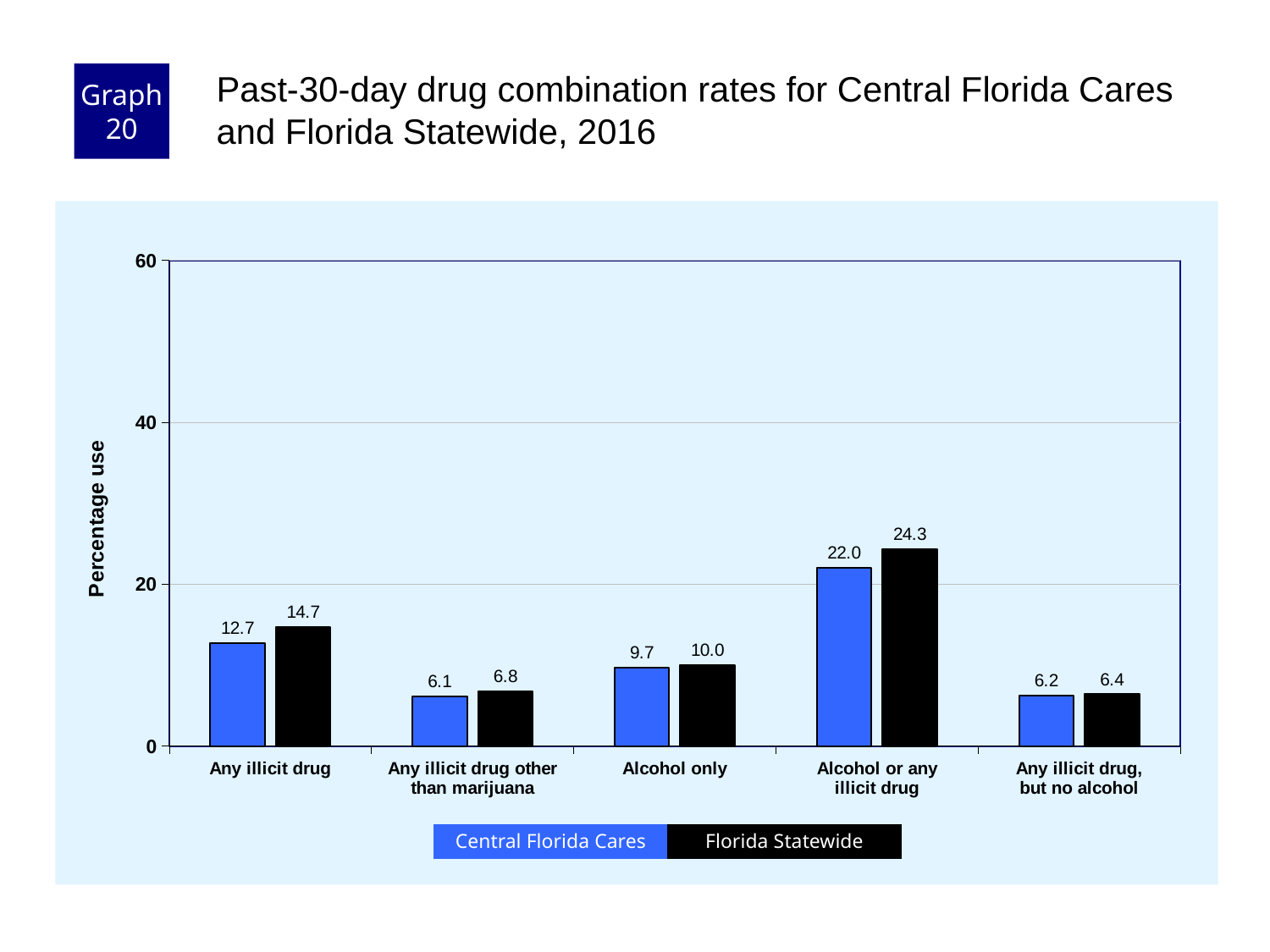
What is the difference between the Florida Statewide and Central Florida Cares values for Alcohol or any illicit drug? 2.3 Is the Florida Statewide value for Alcohol or any illicit drug greater or less than 20? greater What kind of chart is shown on the slide? Bar chart Which category has the lowest Florida Statewide value? Any illicit drug, but no alcohol What is the Florida Statewide value for Alcohol or any illicit drug? 24.3 How many series does the legend list? 2 What is the Florida Statewide value for Alcohol only? 10.0 What is the difference between the Florida Statewide and Central Florida Cares values for Any illicit drug? 2.0 Which category has the highest Central Florida Cares value? Alcohol or any illicit drug Which is larger for Any illicit drug other than marijuana: Central Florida Cares or Florida Statewide? Florida Statewide What is the Central Florida Cares value for Any illicit drug? 12.7 How many categories are shown on the x axis? 5